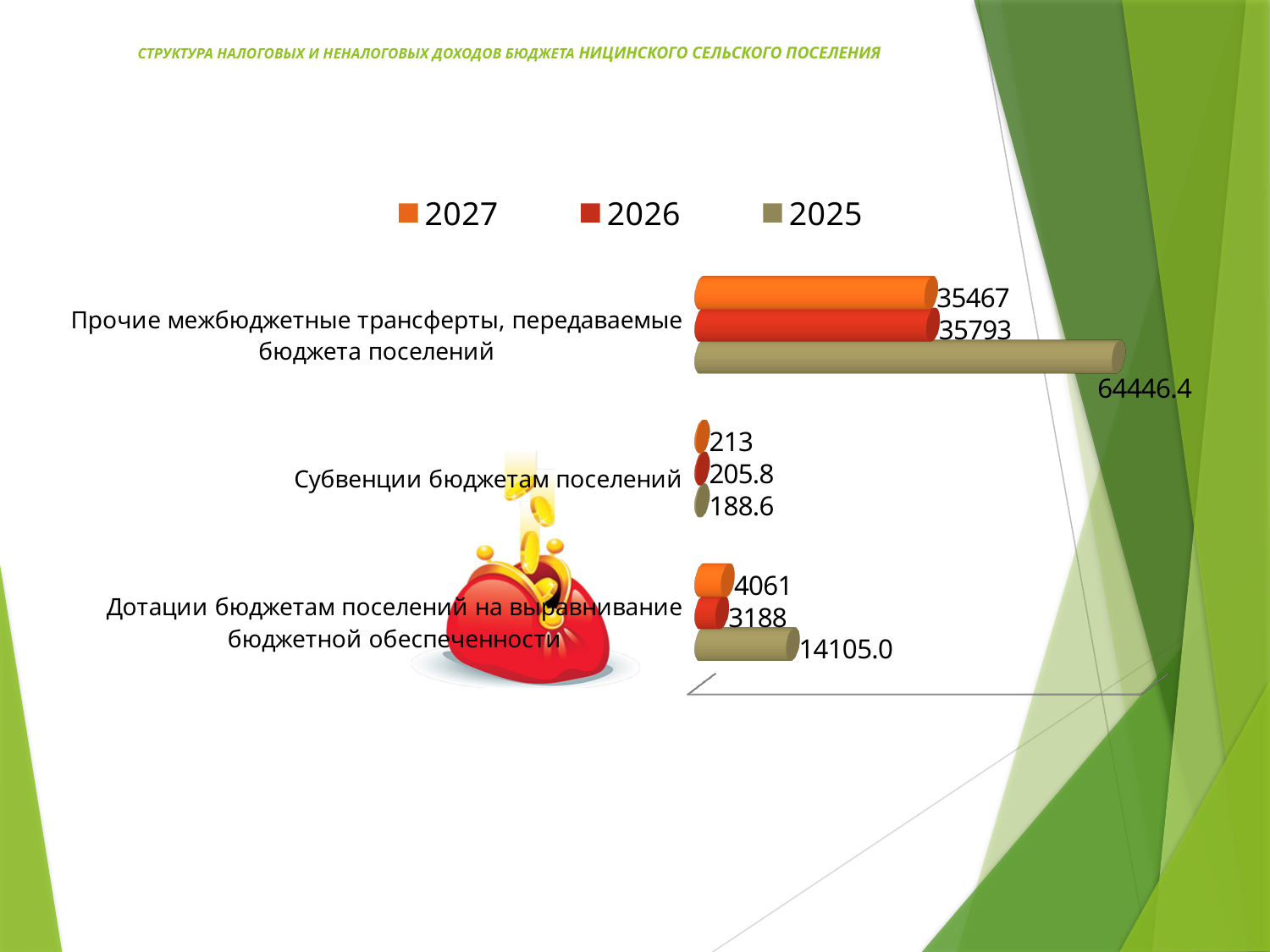
How many series does the legend list? 3 What is the difference between the 2026 and 2027 values for «Прочие межбюджетные трансферты, передаваемые бюджета поселений»? 326 How many categories are shown on the chart? 3 What is the value for 2026 for «Дотации бюджетам поселений на выравнивание бюджетной обеспеченности»? 3188 What is the value for 2025 for «Прочие межбюджетные трансферты, передаваемые бюджета поселений»? 64446.4 What is the difference between the 2027 and 2026 values for «Дотации бюджетам поселений на выравнивание бюджетной обеспеченности»? 873 What kind of chart is shown on the slide? Bar chart Which category has the highest value for 2025? Прочие межбюджетные трансферты, передаваемые бюджета поселений For «Субвенции бюджетам поселений», which is larger: the 2027 value or the 2025 value? 2027 What is the value for 2027 for «Субвенции бюджетам поселений»? 213 What is the value for 2025 for «Дотации бюджетам поселений на выравнивание бюджетной обеспеченности»? 14105.0 Which category has the lowest value for 2027? Субвенции бюджетам поселений